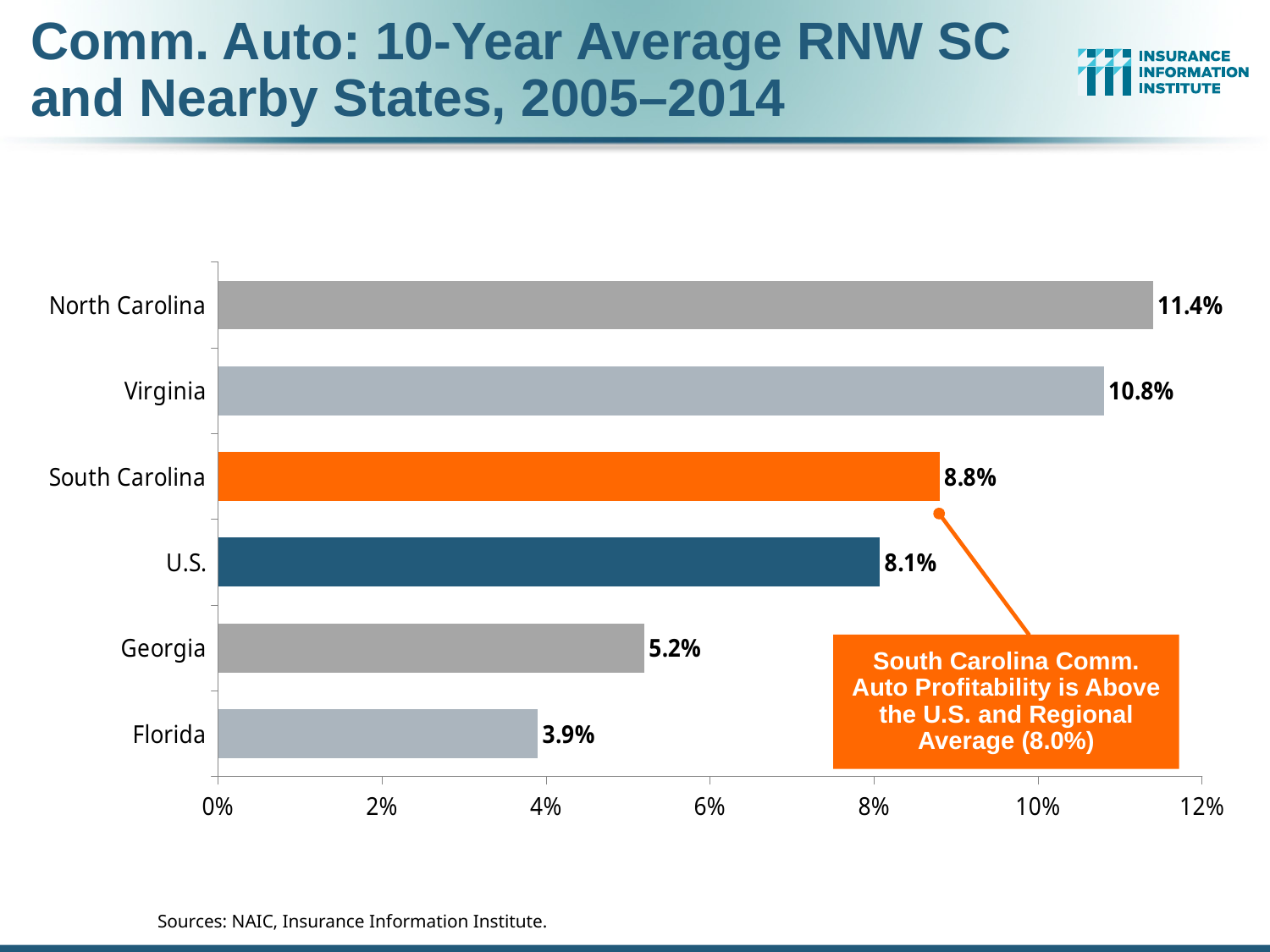
What is the difference between Georgia's value and Florida's value? 1.3% How many categories (bars) are shown on the chart? 6 What is the value shown for Virginia? 10.8% Which state has the highest 10-year average RNW on the chart? North Carolina Is the value for Georgia greater or less than 6%? less What kind of chart is shown on the slide? Bar chart Which state has the lowest 10-year average RNW on the chart? Florida What is the value shown for the U.S.? 8.1% What is the difference between North Carolina's value and South Carolina's value? 2.6% What colour is the South Carolina bar? Orange Which is larger, the value for South Carolina or the value for the U.S.? South Carolina What is the 10-year average RNW for South Carolina? 8.8%